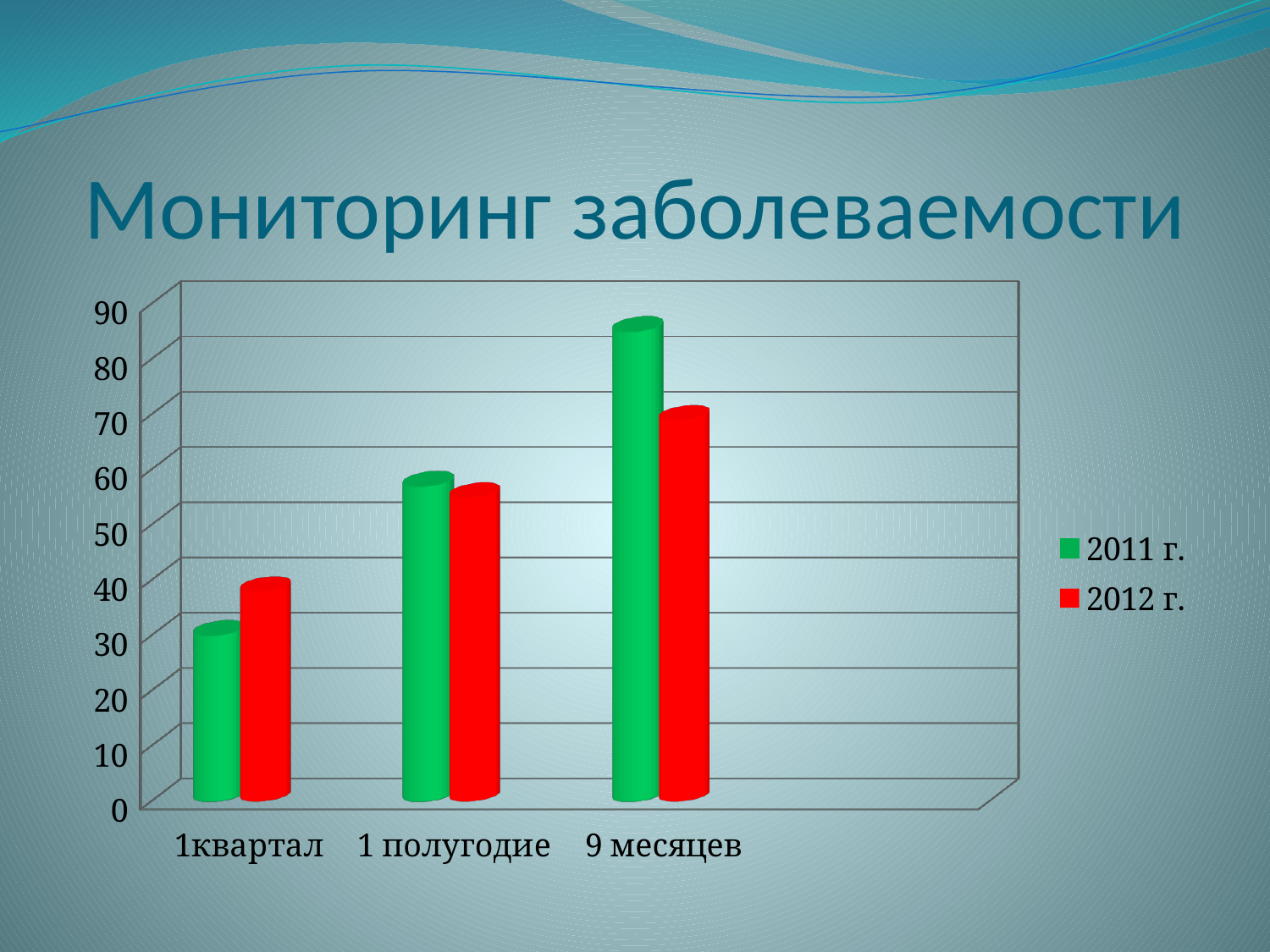
Is the value for 2011 г. in 9 месяцев greater or less than 80? greater Which category has the lowest value for 2012 г.? 1квартал How many categories are shown on the x axis? 3 For 9 месяцев, which series has the larger value, 2011 г. or 2012 г.? 2011 г. Is the value for 2011 г. in 1квартал greater or less than 40? less What kind of chart is shown on the slide? bar chart Do the values for 2011 г. rise or fall from 1квартал to 9 месяцев? rise What is the title of the slide's chart? Мониторинг заболеваемости Is the value for 2012 г. in 9 месяцев greater or less than 80? less How many series does the legend list? 2 Which category has the highest value for 2011 г.? 9 месяцев For 1квартал, which series has the larger value, 2011 г. or 2012 г.? 2012 г.